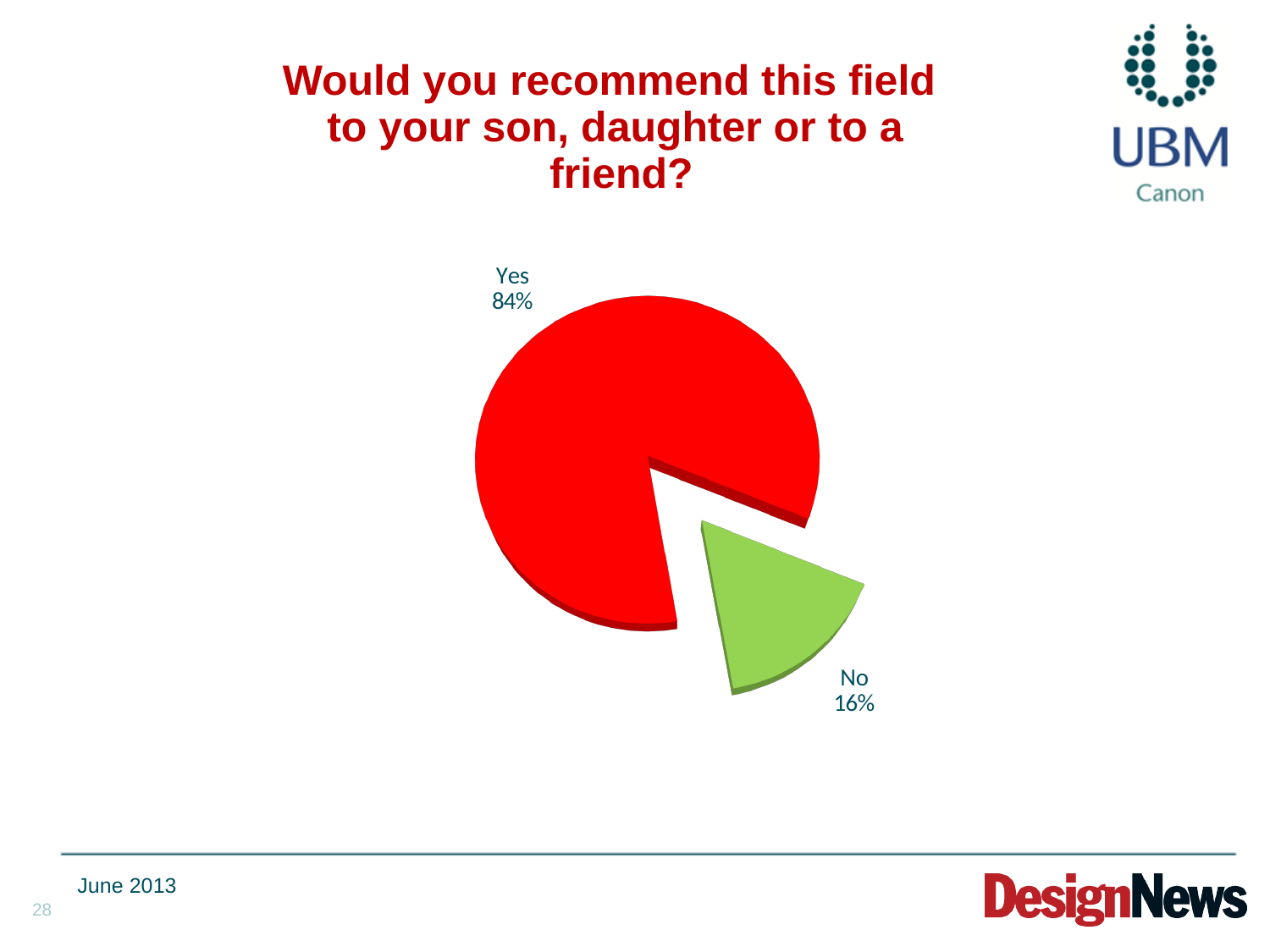
What is the difference in percentage points between the Yes and No shares? 68 How many slices does the pie chart have? 2 What colour is the No slice? Green Which is larger, the Yes share or the No share? Yes What colour is the Yes slice? Red Which response has the smallest share of the pie? No What kind of chart is shown on the slide? Pie chart What percentage of respondents answered No? 16% What share of the pie does the No slice represent? 16% What percentage of respondents answered Yes? 84% Which response has the largest share of the pie? Yes